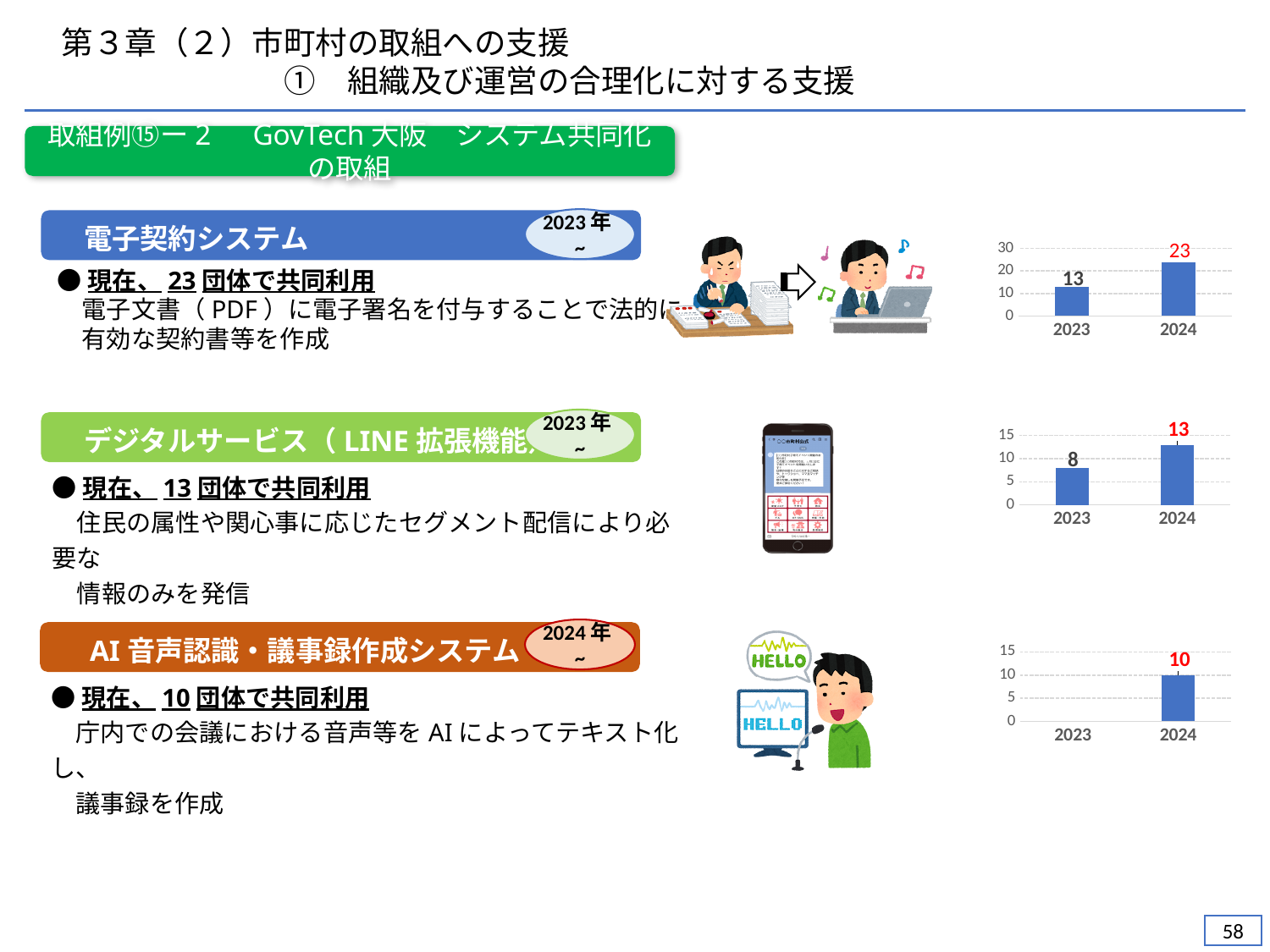
In the middle-right chart, what is the difference between the 2024 and 2023 values? 5 What kind of chart is the bottom-right chart? bar chart In the middle-right chart, what is the value for 2023? 8 In the middle-right chart, is the value for 2024 greater or less than 10? greater In the top-right chart, what is the difference between the 2024 and 2023 values? 10 In the bottom-right chart, what is the value for 2024? 10 In the middle-right chart, what is the value for 2024? 13 In the top-right chart, which year has the higher value? 2024 How many categories are shown on the x axis of the top-right chart? 2 In the top-right chart, what is the value for 2023? 13 In the top-right chart, what is the value for 2024? 23 In the middle-right chart, do the values rise or fall from 2023 to 2024? rise